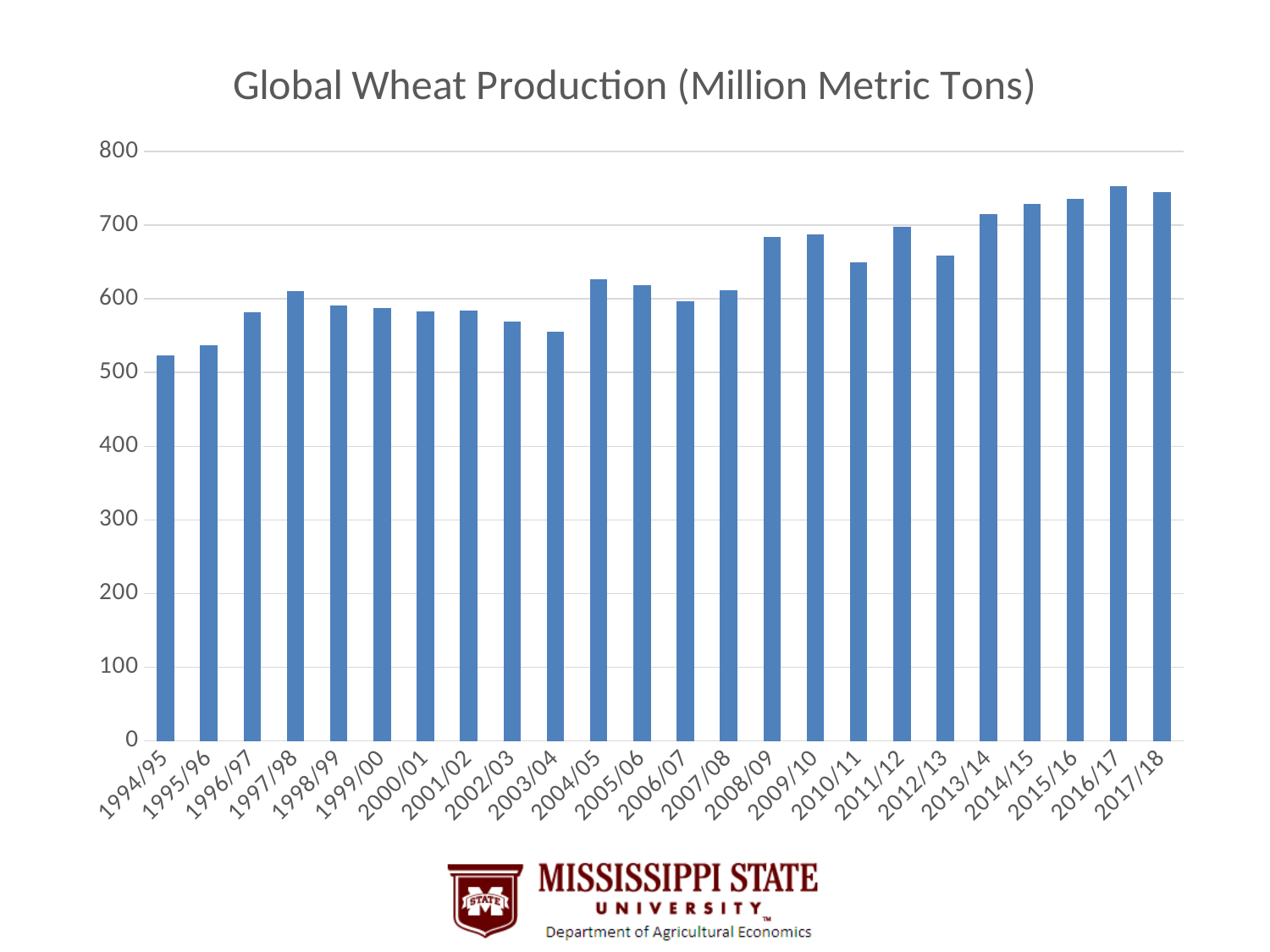
Which is larger, the value for 2010/11 or 2011/12? 2011/12 How many marketing years (bars) are shown on the chart? 24 Is the value for 2016/17 greater or less than 700? greater Which is larger, the value for 2007/08 or 2008/09? 2008/09 What kind of chart is shown on the slide? Bar chart Is the value for 1994/95 greater or less than 600? less Is the value for 2012/13 greater or less than 700? less What is the title of the chart? Global Wheat Production (Million Metric Tons) Which is larger, the value for 2003/04 or 2004/05? 2004/05 Overall, do the values rise or fall from 1994/95 to 2017/18? rise Which year has the lowest global wheat production? 1994/95